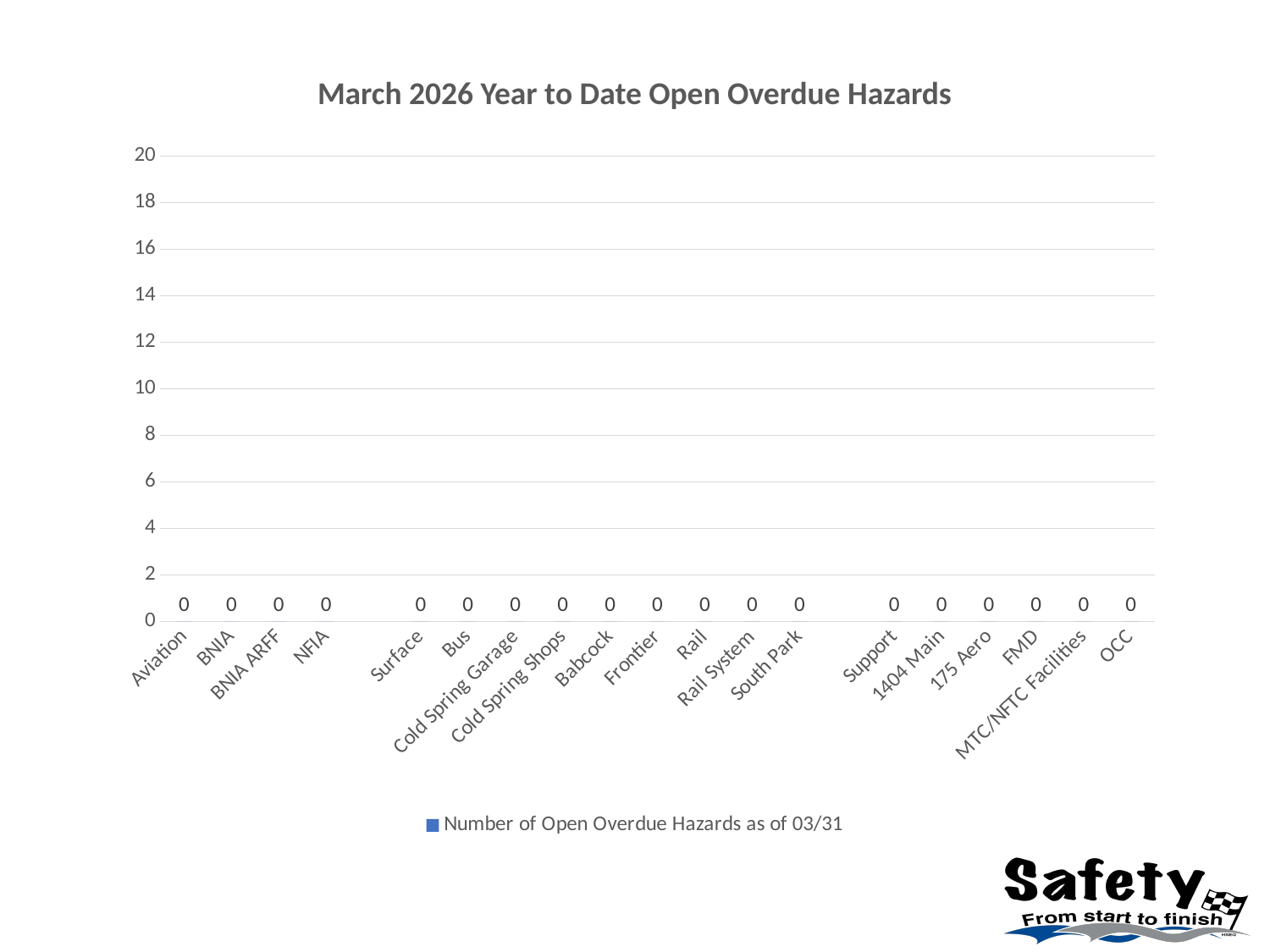
What kind of chart is this? bar chart What is the value for Cold Spring Garage? 0 How many series does the legend list? 1 Do the values rise, fall, or stay flat from Aviation to OCC? stay flat What is the difference between the values for Rail System and South Park? 0 What is the title of the chart? March 2026 Year to Date Open Overdue Hazards What is the value for Aviation? 0 Is the value for OCC greater or less than 10? less Is the value for Babcock greater or less than 2? less How many categories are shown on the x axis? 19 What is the value for 175 Aero? 0 What is the value for MTC/NFTC Facilities? 0